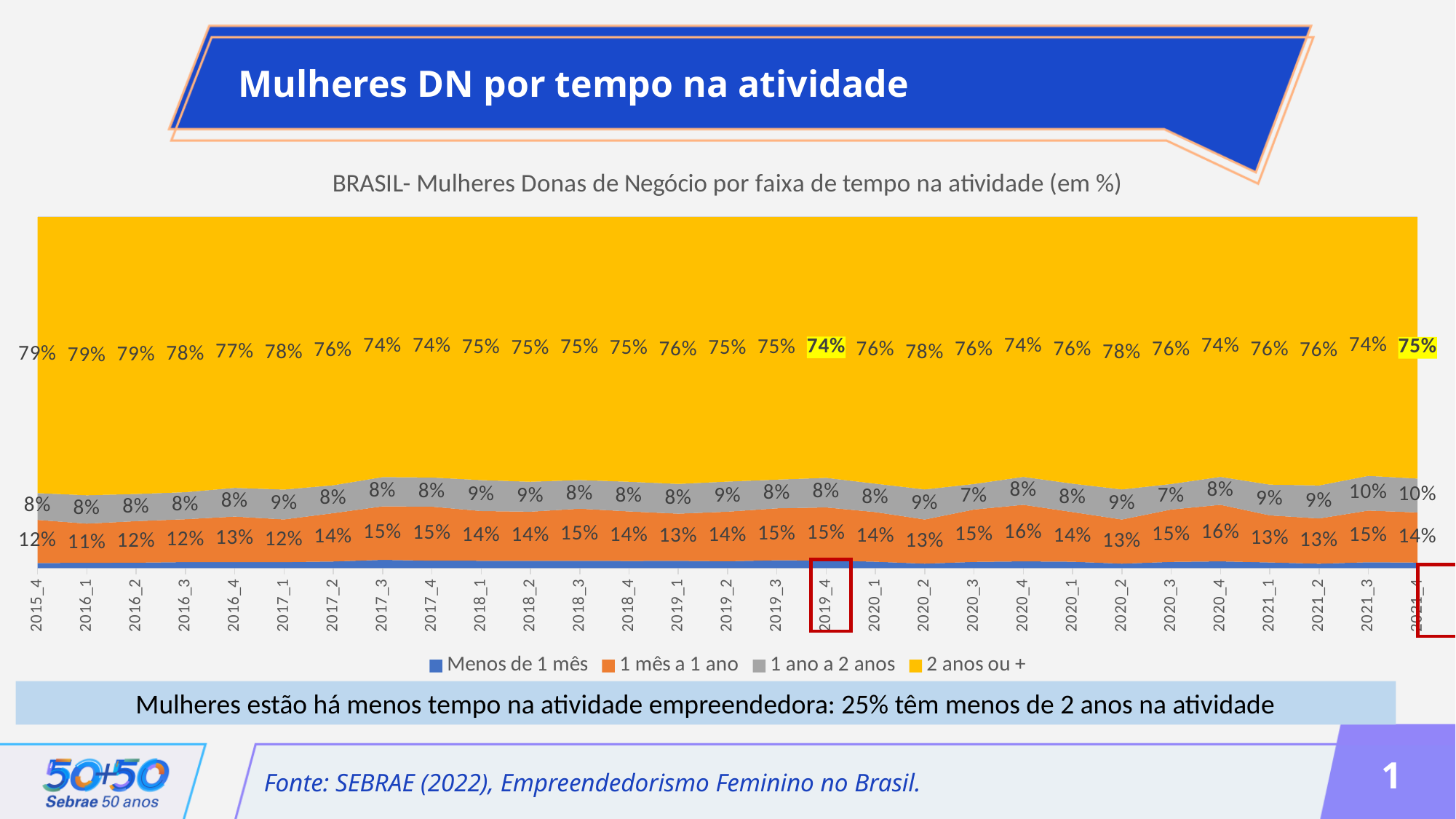
What is the value of '2 anos ou +' for 2019_4? 74% What is the value of '1 ano a 2 anos' for 2021_4? 10% Which is larger for '2 anos ou +': the value for 2015_4 or the value for 2021_4? 2015_4 What is the title shown above the chart? BRASIL- Mulheres Donas de Negócio por faixa de tempo na atividade (em %) What is the value of '2 anos ou +' for 2021_4? 75% Does the share of '2 anos ou +' rise or fall overall from 2015_4 to 2021_4? Fall How many series does the legend list? 4 What is the difference between the '2 anos ou +' values for 2015_4 and 2021_4? 4 percentage points What is the value of '1 mês a 1 ano' for 2015_4? 12% What is the value of '2 anos ou +' for 2015_4? 79% What kind of chart is shown on the slide? Stacked area chart What is the value of '1 mês a 1 ano' for 2021_4? 14%